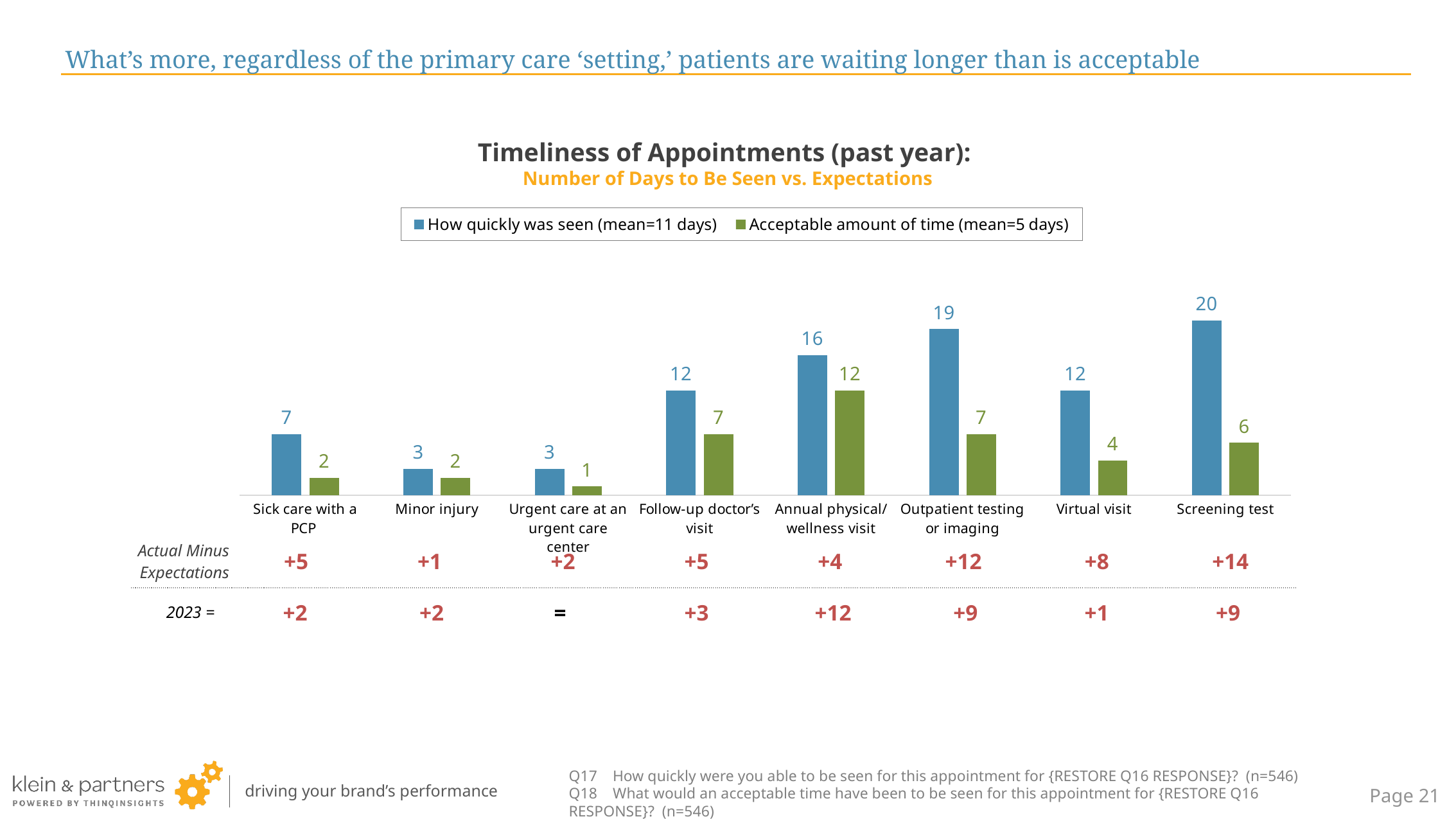
How many series does the legend list? 2 What is the 'Actual Minus Expectations' value shown for Screening test? +14 Which is larger for Virtual visit: 'How quickly was seen' or 'Acceptable amount of time'? How quickly was seen What mean is given in the legend for 'How quickly was seen'? 11 days What is the difference between 'How quickly was seen' and 'Acceptable amount of time' for Outpatient testing or imaging? 12 Which category has the highest 'How quickly was seen' value? Screening test How many categories are shown on the x axis of the chart? 8 What is the 'How quickly was seen' value for Urgent care at an urgent care center? 3 What is the value of 'How quickly was seen' for Screening test? 20 What is the 'Acceptable amount of time' value for Annual physical/ wellness visit? 12 What kind of chart is shown on the slide? Bar chart Which category has the lowest 'Acceptable amount of time' value? Urgent care at an urgent care center